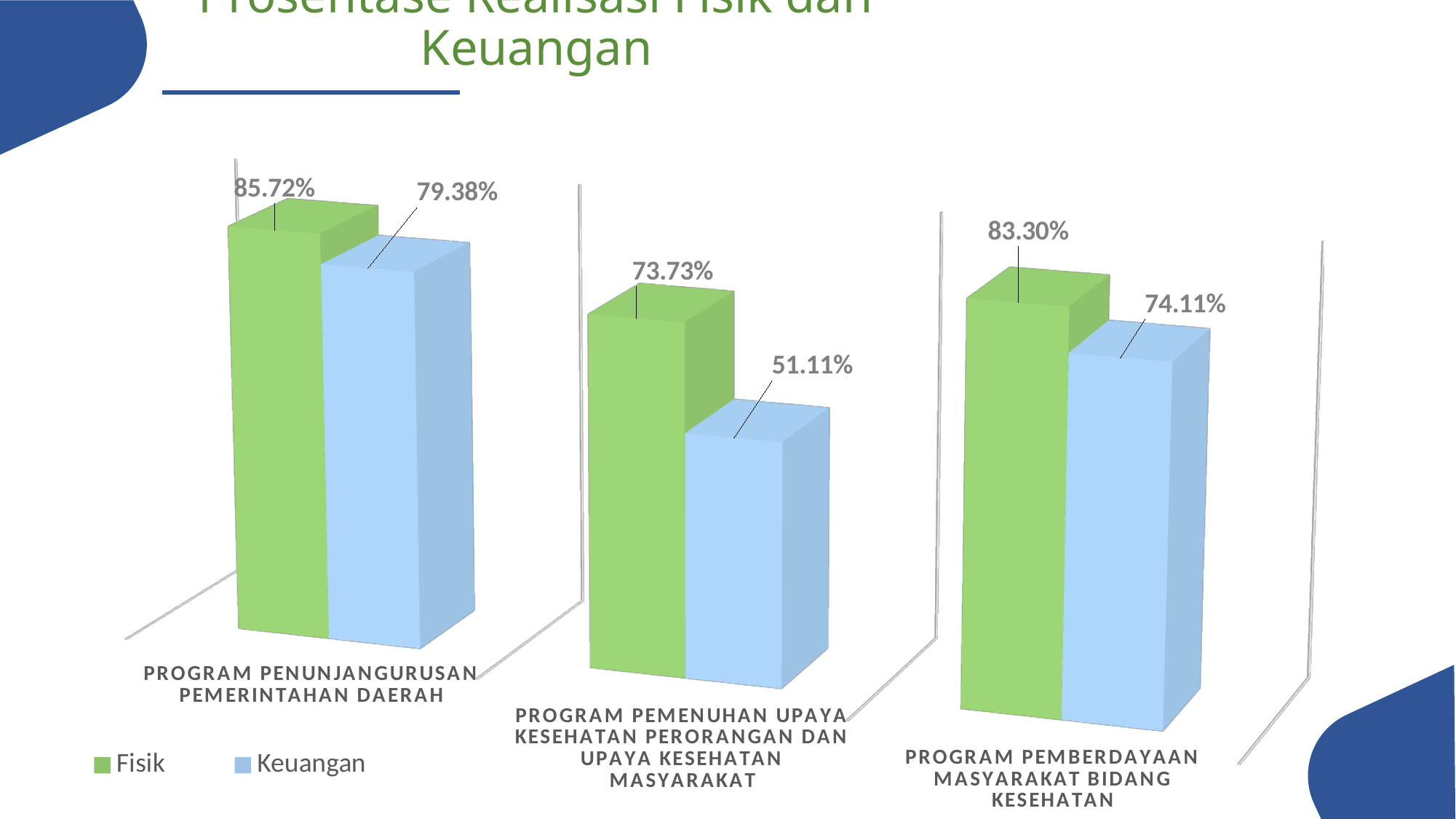
What kind of chart is shown on the slide? Bar chart What is the Fisik value for Program Pemberdayaan Masyarakat Bidang Kesehatan? 83.30% How many programs (categories) are shown in the chart? 3 How many series does the legend list? 2 What is the Keuangan value for Program Pemberdayaan Masyarakat Bidang Kesehatan? 74.11% What is the difference between the Fisik and Keuangan values for Program Penunjang Urusan Pemerintahan Daerah? 6.34% What is the difference between the Fisik and Keuangan values for Program Pemenuhan Upaya Kesehatan Perorangan dan Upaya Kesehatan Masyarakat? 22.62% Which program has the highest Fisik value? Program Penunjang Urusan Pemerintahan Daerah Which is larger: the Keuangan value for Program Penunjang Urusan Pemerintahan Daerah or the Keuangan value for Program Pemberdayaan Masyarakat Bidang Kesehatan? Program Penunjang Urusan Pemerintahan Daerah What is the Fisik value for Program Penunjang Urusan Pemerintahan Daerah? 85.72% What is the Keuangan value for Program Pemenuhan Upaya Kesehatan Perorangan dan Upaya Kesehatan Masyarakat? 51.11% Which program has the lowest Keuangan value? Program Pemenuhan Upaya Kesehatan Perorangan dan Upaya Kesehatan Masyarakat